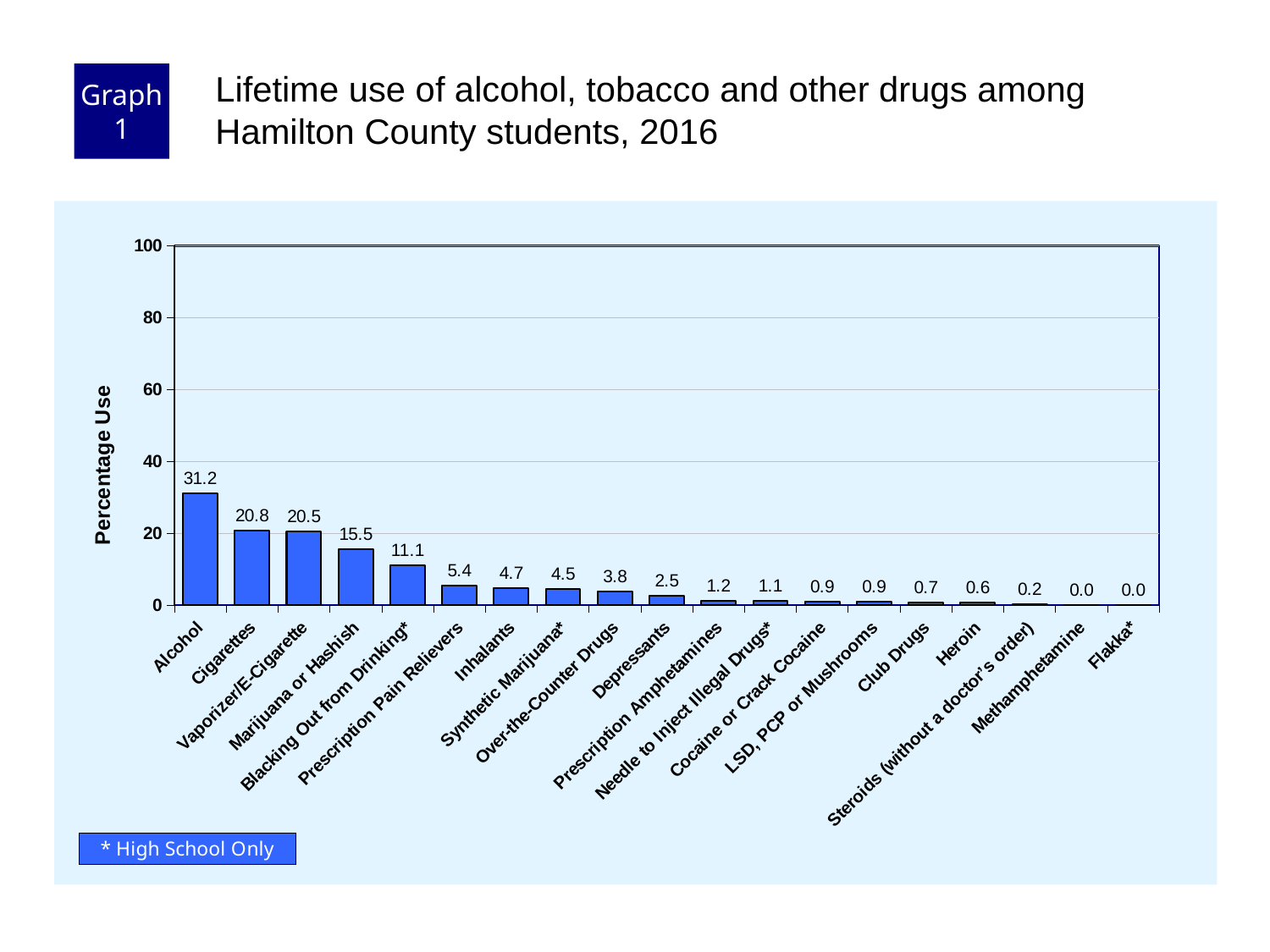
What is the difference in percentage use between Alcohol and Cigarettes? 10.4 How many categories are shown on the x axis? 19 What is the percentage use for Heroin? 0.6 What is the percentage use for Blacking Out from Drinking*? 11.1 What kind of chart is shown on the slide? Bar chart Is the value for Alcohol greater or less than 40? less What is the difference in percentage use between Marijuana or Hashish and Prescription Pain Relievers? 10.1 What is the percentage use for Alcohol? 31.2 Which has a higher percentage use, Inhalants or Over-the-Counter Drugs? Inhalants What is the percentage use for Vaporizer/E-Cigarette? 20.5 Which category has the highest percentage use? Alcohol Which categories have the lowest percentage use? Methamphetamine and Flakka*